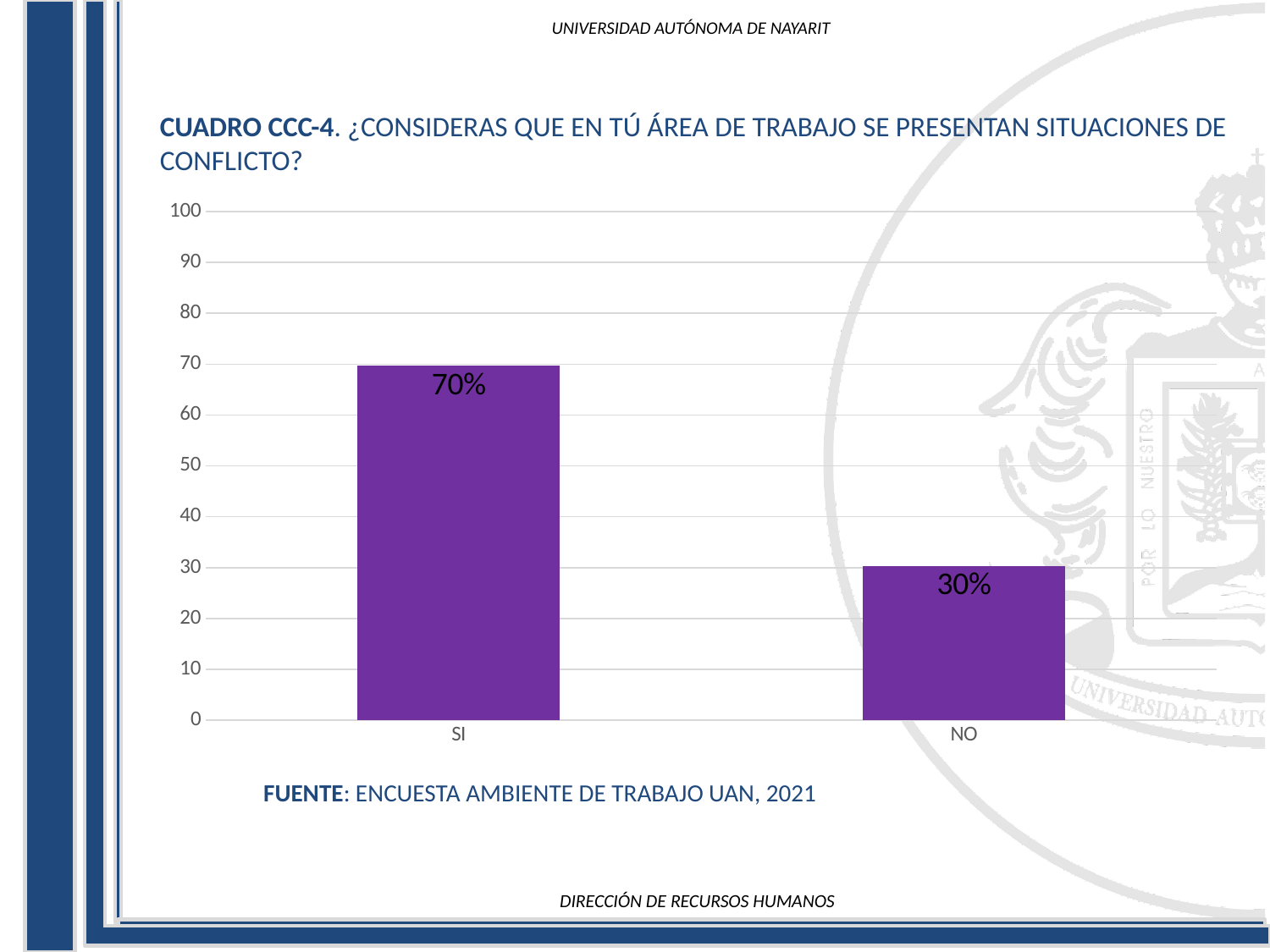
Which category has the lowest value? NO Which category has the highest value? SI What is the difference between the values for SI and NO? 40% Is the value for SI greater or less than 50? greater Is the value for NO greater or less than 40? less What kind of chart is shown on the slide? bar chart What is the value for NO? 30% What is the highest value shown on the vertical axis? 100 How many categories are shown on the x axis? 2 What source is cited below the chart? ENCUESTA AMBIENTE DE TRABAJO UAN, 2021 What is the value for SI? 70% Which is larger, the value for SI or the value for NO? SI